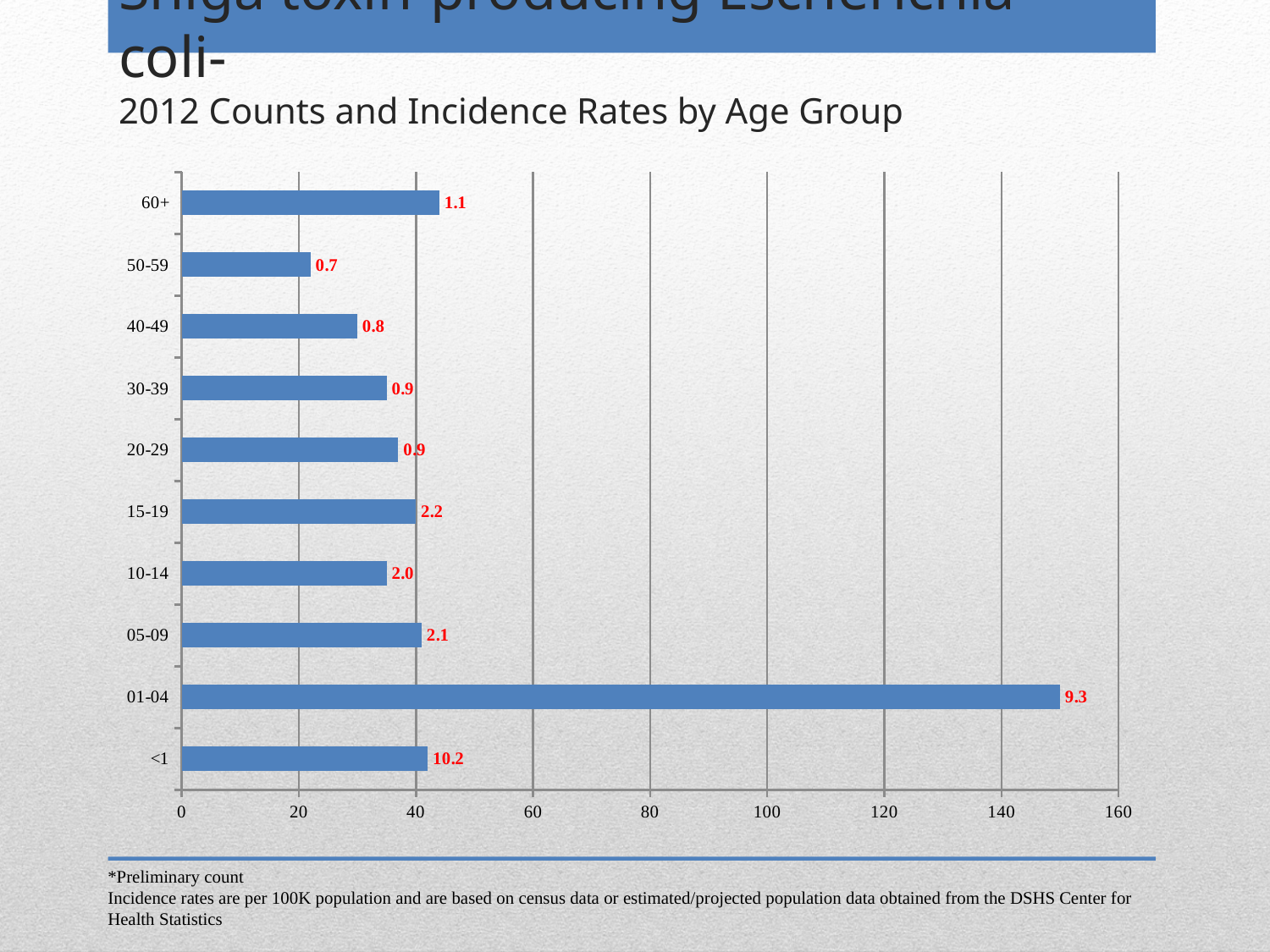
How many age groups are shown on the chart? 10 Which has the higher labeled incidence rate, the 60+ age group or the 40-49 age group? 60+ Is the count for the 01-04 age group greater or less than 140? greater What incidence rate is labeled on the bar for the 01-04 age group? 9.3 What incidence rate is labeled on the bar for the 50-59 age group? 0.7 What is the difference between the labeled incidence rates for the <1 and 01-04 age groups? 0.9 What incidence rate is labeled on the bar for the 15-19 age group? 2.2 What type of chart is shown on the slide? Bar chart Is the count for the 50-59 age group greater or less than 40? less Which age group has the longest bar (highest count)? 01-04 Which age group has the shortest bar (lowest count)? 50-59 What incidence rate is labeled on the bar for the <1 age group? 10.2